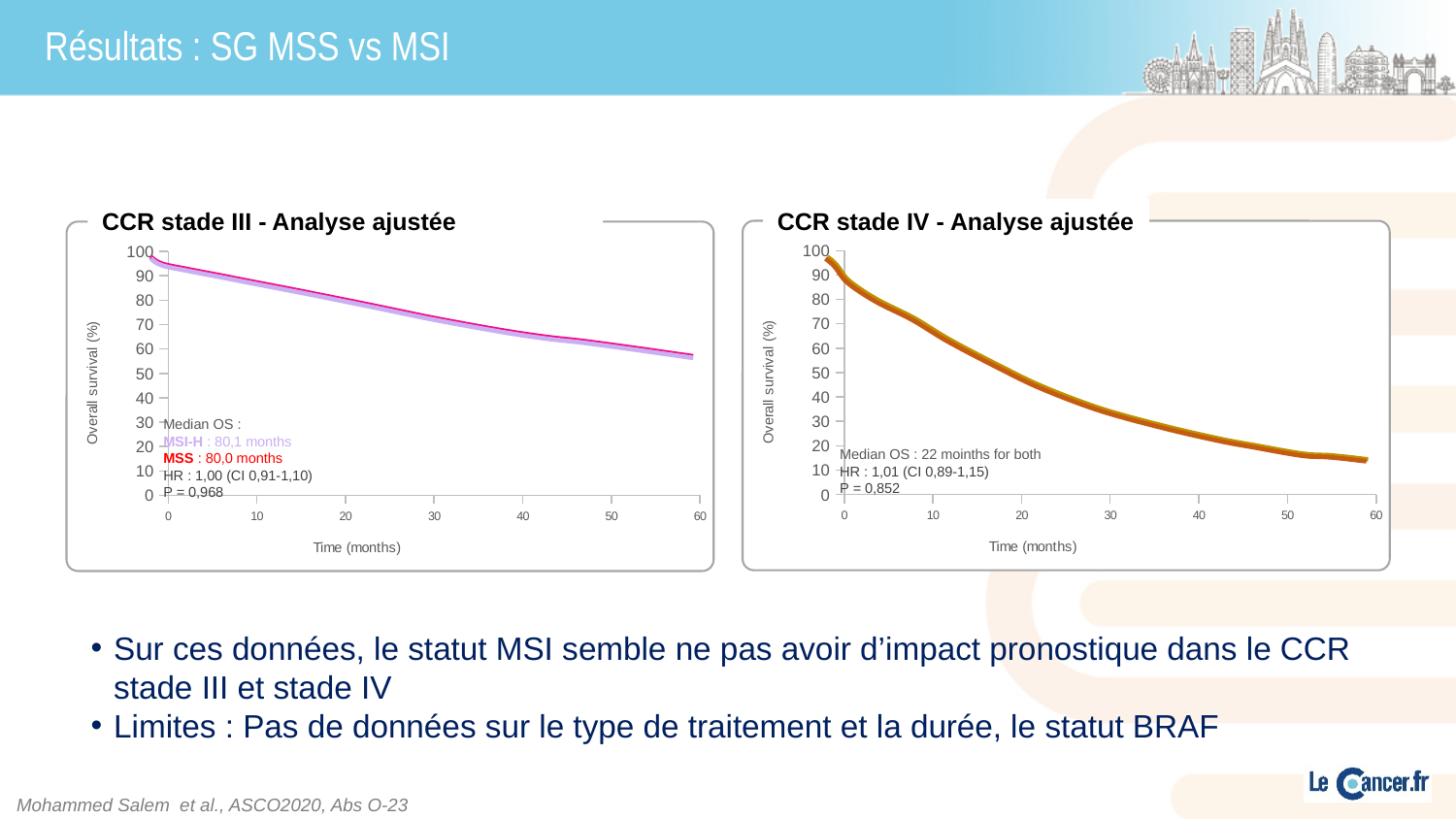
In the 'CCR stade III - Analyse ajustée' chart, what is the median OS for MSS? 80,0 months In the 'CCR stade IV - Analyse ajustée' chart, what is the median OS reported for both groups? 22 months In the 'CCR stade III - Analyse ajustée' chart, is the overall survival at 60 months greater or less than 50? greater What is the label of the x axis on the 'CCR stade III - Analyse ajustée' chart? Time (months) In the 'CCR stade IV - Analyse ajustée' chart, is the overall survival at 20 months greater or less than 40? greater In the 'CCR stade III - Analyse ajustée' chart, what is the median OS for MSI-H? 80,1 months In the 'CCR stade IV - Analyse ajustée' chart, is the overall survival at 60 months greater or less than 20? less In the 'CCR stade III - Analyse ajustée' chart, do the survival curves rise or fall as time increases? Fall In the 'CCR stade III - Analyse ajustée' chart, what is the hazard ratio (HR) shown? 1,00 (CI 0,91-1,10) What kind of chart is the 'CCR stade III - Analyse ajustée' chart? Line chart In the 'CCR stade IV - Analyse ajustée' chart, do the survival curves rise or fall along the x axis? Fall In the 'CCR stade IV - Analyse ajustée' chart, what is the P value shown? 0,852